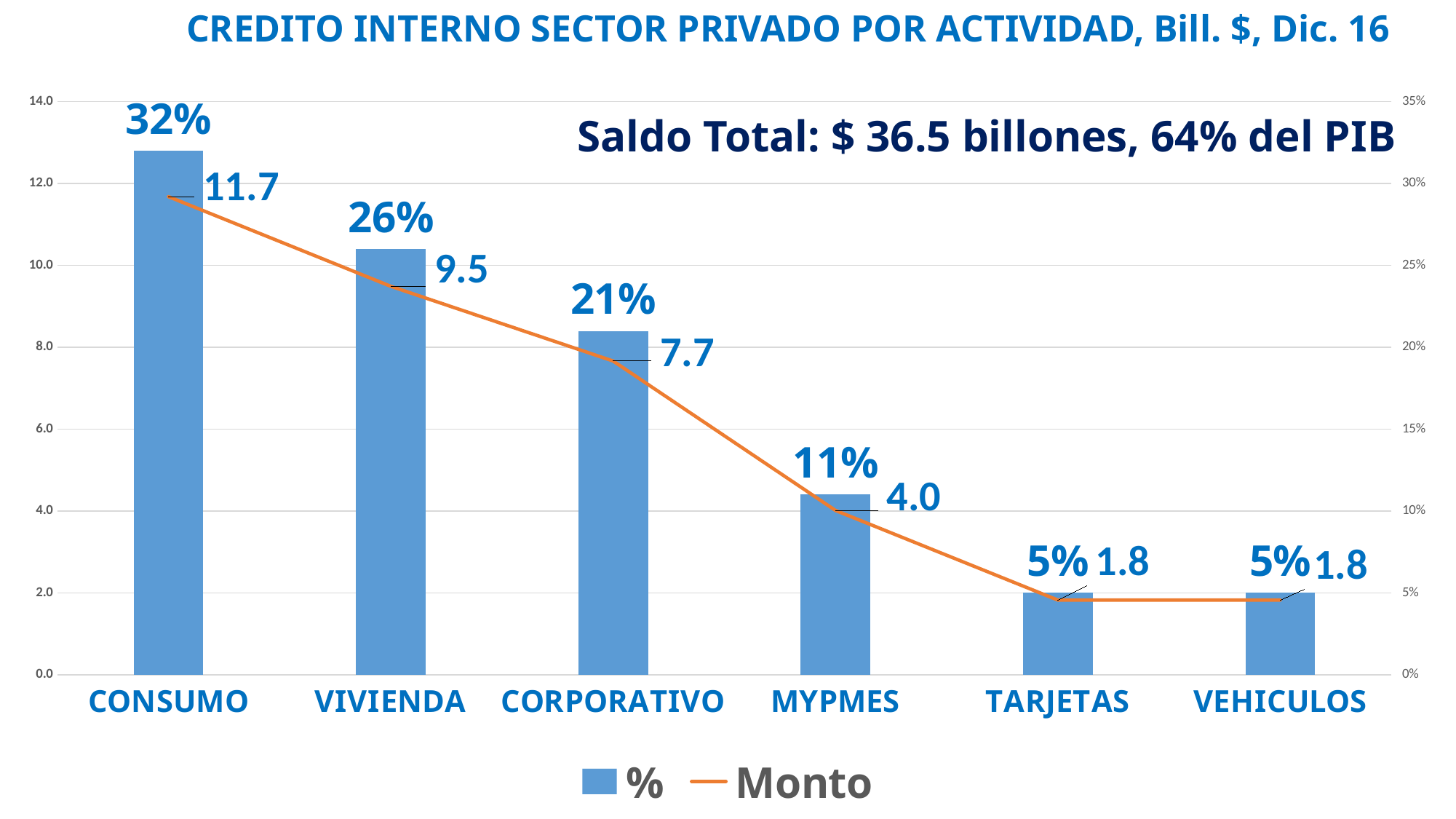
Do the Monto values rise or fall from CONSUMO to MYPMES? fall Which category has the highest Monto value? CONSUMO What is the % value for CORPORATIVO? 21% What is the Monto value for MYPMES? 4.0 What is the Monto value for VIVIENDA? 9.5 How many categories are shown on the x axis? 6 Which category has the lowest % value, TARJETAS or MYPMES? TARJETAS What is the difference between the % values for VIVIENDA and CORPORATIVO? 5% What is the title of the chart? CREDITO INTERNO SECTOR PRIVADO POR ACTIVIDAD, Bill. $, Dic. 16 What is the difference between the Monto values for CONSUMO and VIVIENDA? 2.2 How many series does the legend list? 2 What is the % value for CONSUMO? 32%